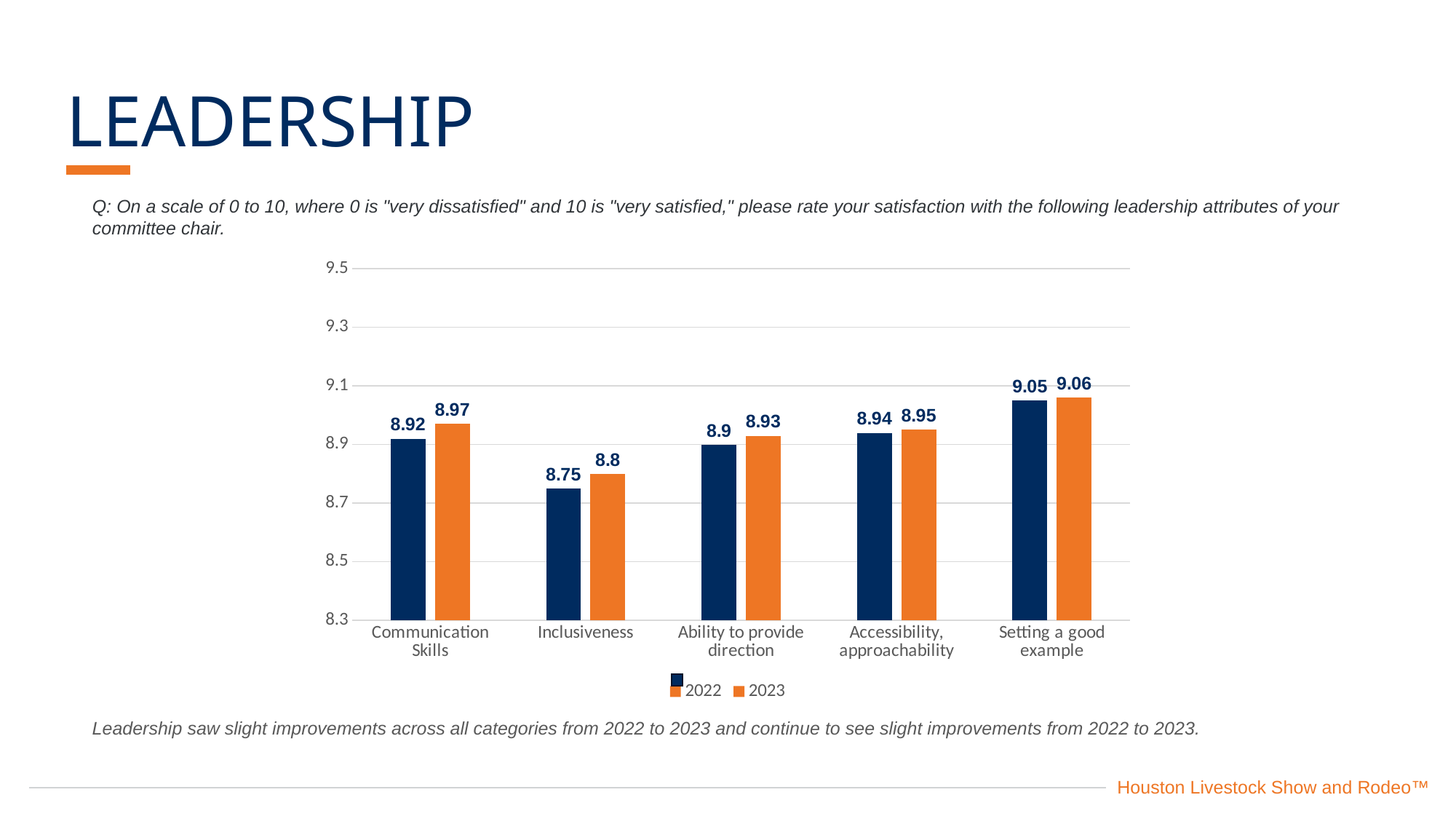
Which category has the lowest 2022 value? Inclusiveness How many series does the legend list? 2 What is the 2023 value for Communication Skills? 8.97 What is the difference between the 2023 and 2022 values for Inclusiveness? 0.05 What is the 2022 value for Inclusiveness? 8.75 What is the 2023 value for Setting a good example? 9.06 What kind of chart is shown on the slide? bar chart Which category has the highest 2023 value? Setting a good example What is the 2022 value for Ability to provide direction? 8.9 Is the 2022 value for Setting a good example greater or less than 9.1? less Which is larger for Accessibility, approachability: the 2022 value or the 2023 value? 2023 How many categories are shown on the x axis? 5